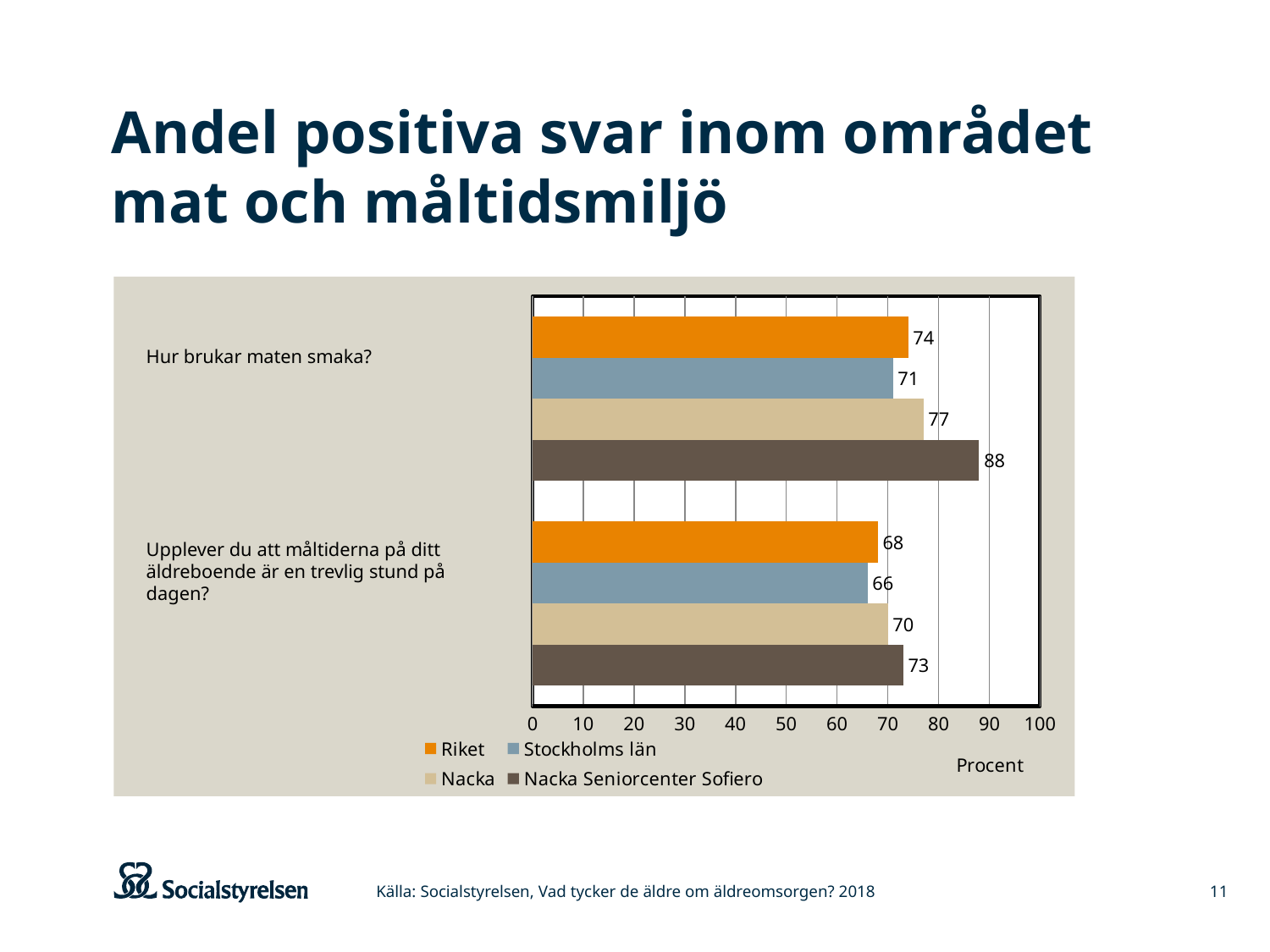
What value is shown for Nacka for "Upplever du att måltiderna på ditt äldreboende är en trevlig stund på dagen?"? 70 What kind of chart is shown on the slide? Bar chart What is the difference between the Nacka Seniorcenter Sofiero value and the Riket value for "Hur brukar maten smaka?"? 14 What is the label of the x axis? Procent What value is shown for Riket for "Upplever du att måltiderna på ditt äldreboende är en trevlig stund på dagen?"? 68 Which series has the highest value for "Hur brukar maten smaka?"? Nacka Seniorcenter Sofiero How many series does the legend list? 4 Which is larger for "Upplever du att måltiderna på ditt äldreboende är en trevlig stund på dagen?": Nacka or Nacka Seniorcenter Sofiero? Nacka Seniorcenter Sofiero How many questions (categories) are shown on the chart? 2 What value is shown for Nacka Seniorcenter Sofiero for "Hur brukar maten smaka?"? 88 What value is shown for Stockholms län for "Hur brukar maten smaka?"? 71 Which series has the lowest value for "Upplever du att måltiderna på ditt äldreboende är en trevlig stund på dagen?"? Stockholms län